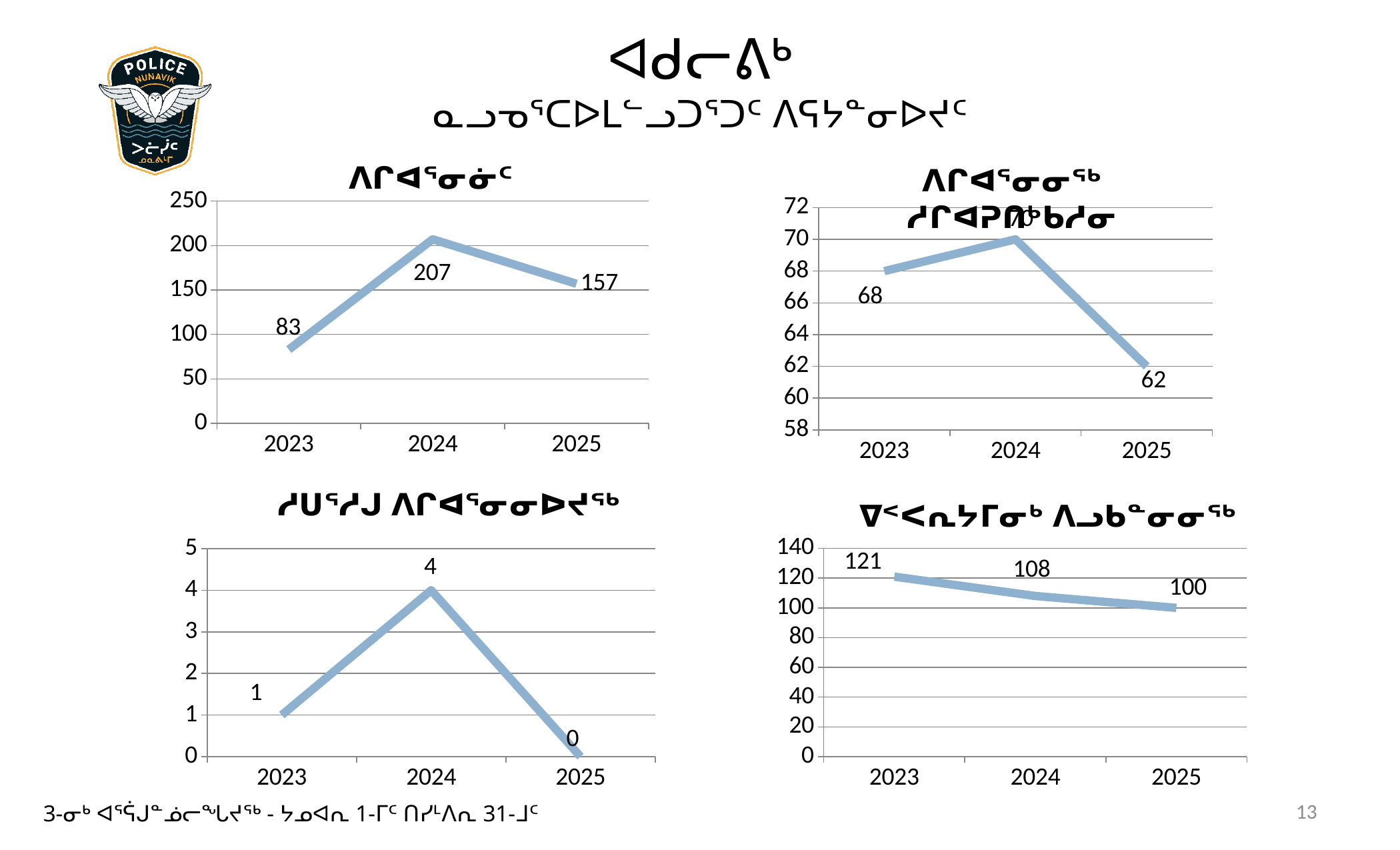
In the top-right chart, what is the value for 2025? 62 How many charts are on the slide, and what type are they? 4 line charts In the bottom-left chart, what is the value for 2024? 4 In the bottom-right chart, do the values rise or fall from 2023 to 2025? fall In the top-right chart, which year has the highest value? 2024 In the top-right chart, is the value for 2023 larger or smaller than the value for 2025? larger In the bottom-right chart, what is the value for 2023? 121 In the top-left chart, which year has the lowest value? 2023 In the bottom-left chart, what is the value for 2025? 0 In the top-left chart, what is the value for 2024? 207 In the top-left chart, what is the difference between the 2024 and 2025 values? 50 In the bottom-right chart, what is the difference between the 2023 and 2025 values? 21